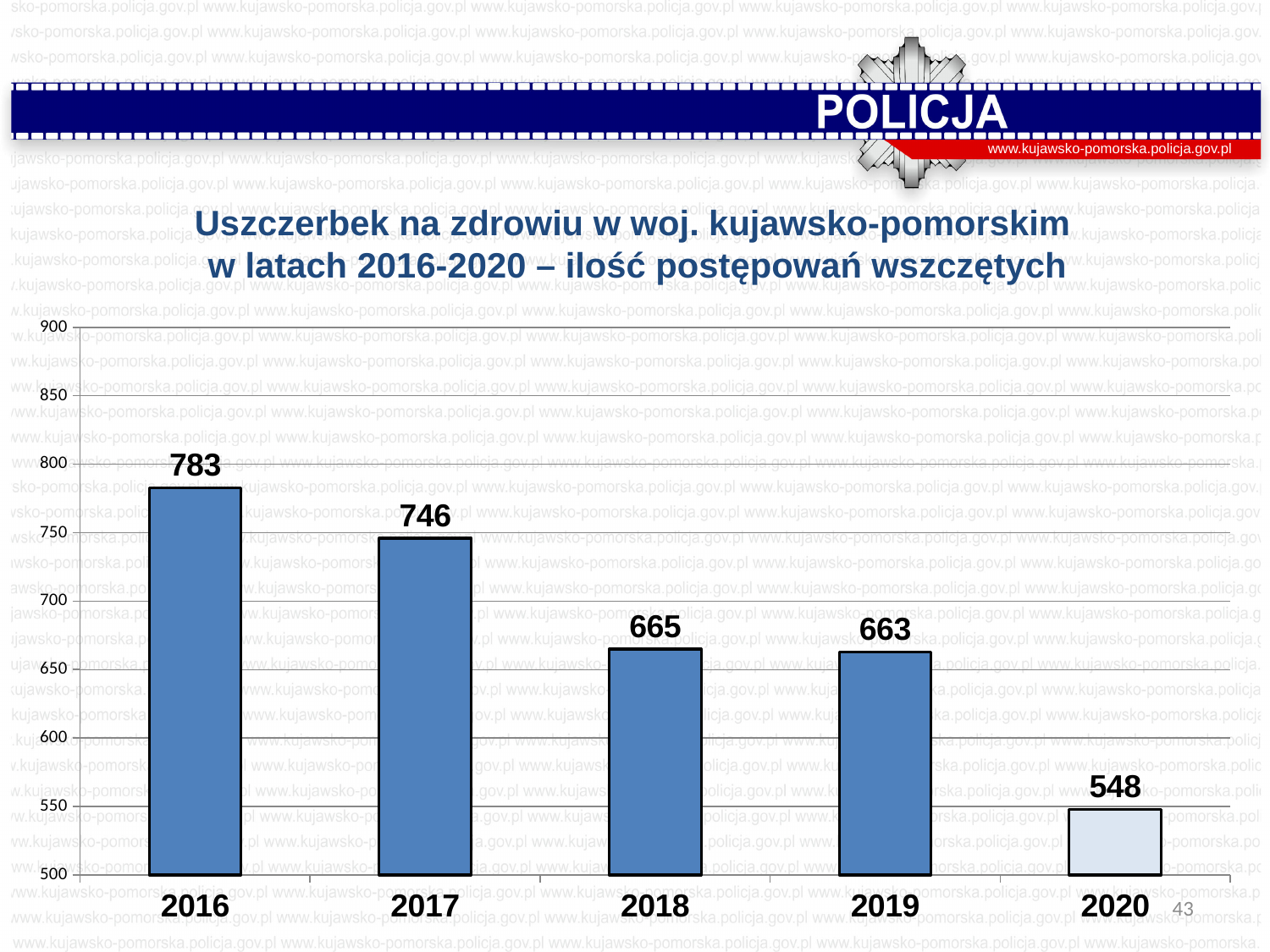
What is the difference between the values for 2019 and 2020? 115 Do the values rise or fall from 2016 to 2020? fall How many years are shown on the chart? 5 What is the value for 2020? 548 Which year has the highest value? 2016 Which is larger, the value for 2017 or the value for 2019? 2017 What is the value for 2016? 783 Is the value for 2017 greater or less than 700? greater What is the value for 2018? 665 What kind of chart is shown on the slide? bar chart What is the difference between the values for 2016 and 2017? 37 Which year has the lowest value? 2020